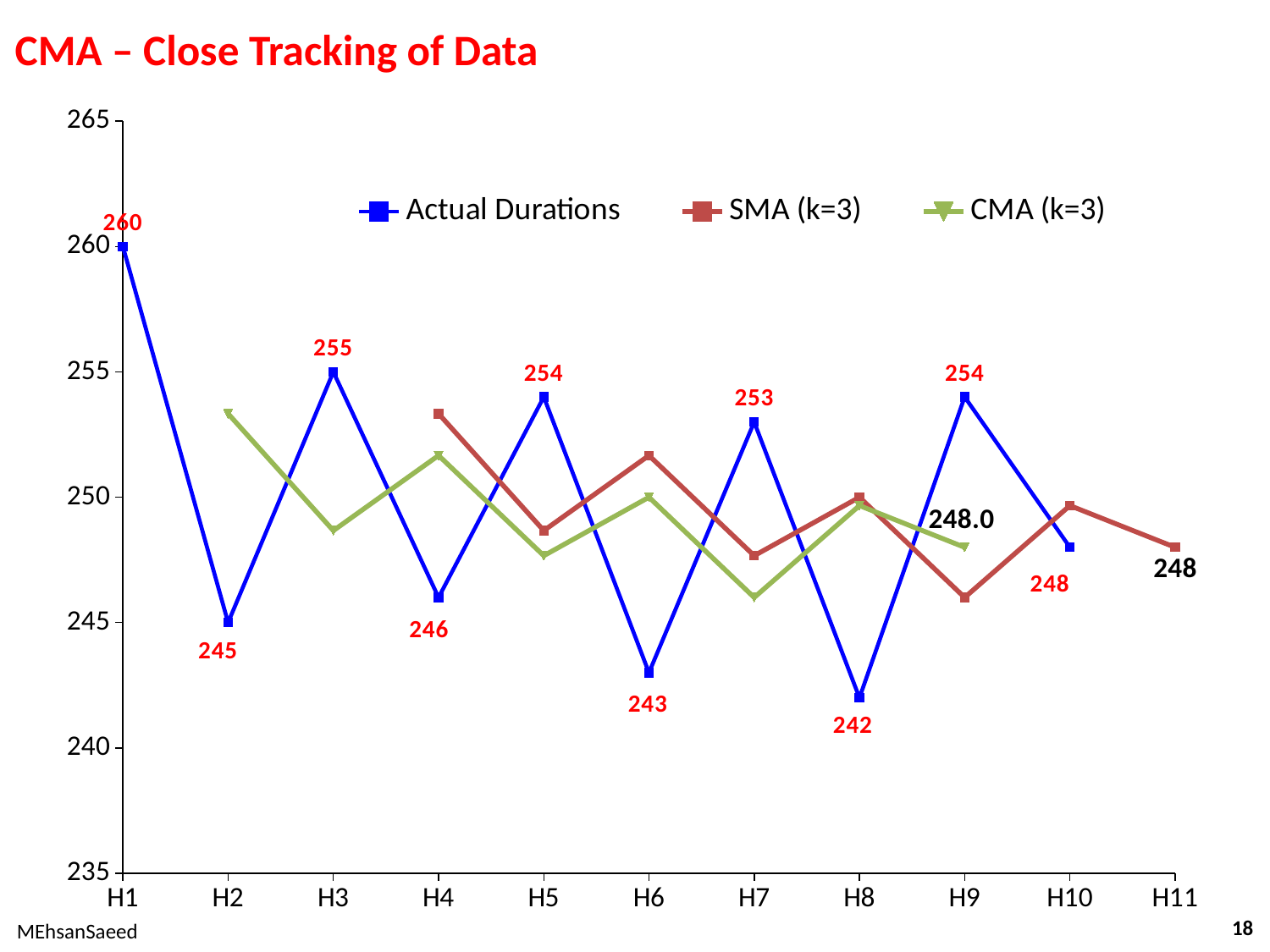
At which period is Actual Durations highest? H1 What is the difference between Actual Durations at H1 and at H2? 15 What is the value of Actual Durations at H8? 242 What is the value of CMA (k=3) at H9? 248.0 What is the value of Actual Durations at H1? 260 Which is larger for Actual Durations: H3 or H5? H3 Is the value of CMA (k=3) at H7 greater or less than 250? less At which period is Actual Durations lowest? H8 How many periods are shown on the x axis? 11 Is the value of SMA (k=3) at H4 greater or less than 250? greater How many series does the legend list? 3 What is the value of SMA (k=3) at H11? 248